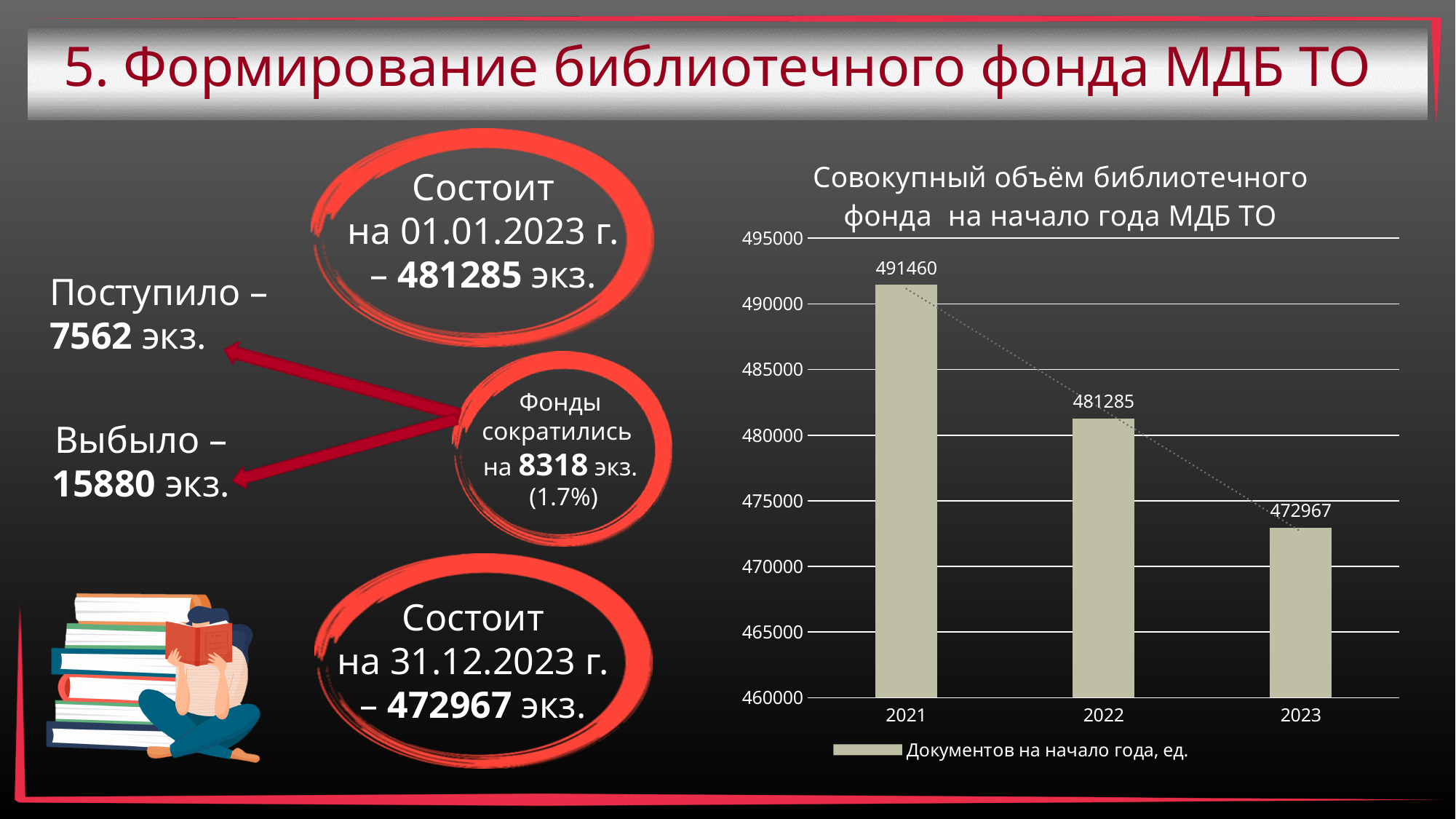
How many years are shown in the chart? 3 What is the value for 2022 in the chart? 481285 What is the value for 2023 in the chart? 472967 What is the difference between the values for 2021 and 2023? 18493 Do the values rise or fall from 2021 to 2023? fall Which year has the highest value in the chart? 2021 What kind of chart is shown on the slide? bar chart What is the legend entry of the chart? Документов на начало года, ед. What is the difference between the values for 2022 and 2023? 8318 Which is larger, the value for 2021 or the value for 2022? 2021 Which year has the lowest value in the chart? 2023 What is the value for 2021 in the chart? 491460